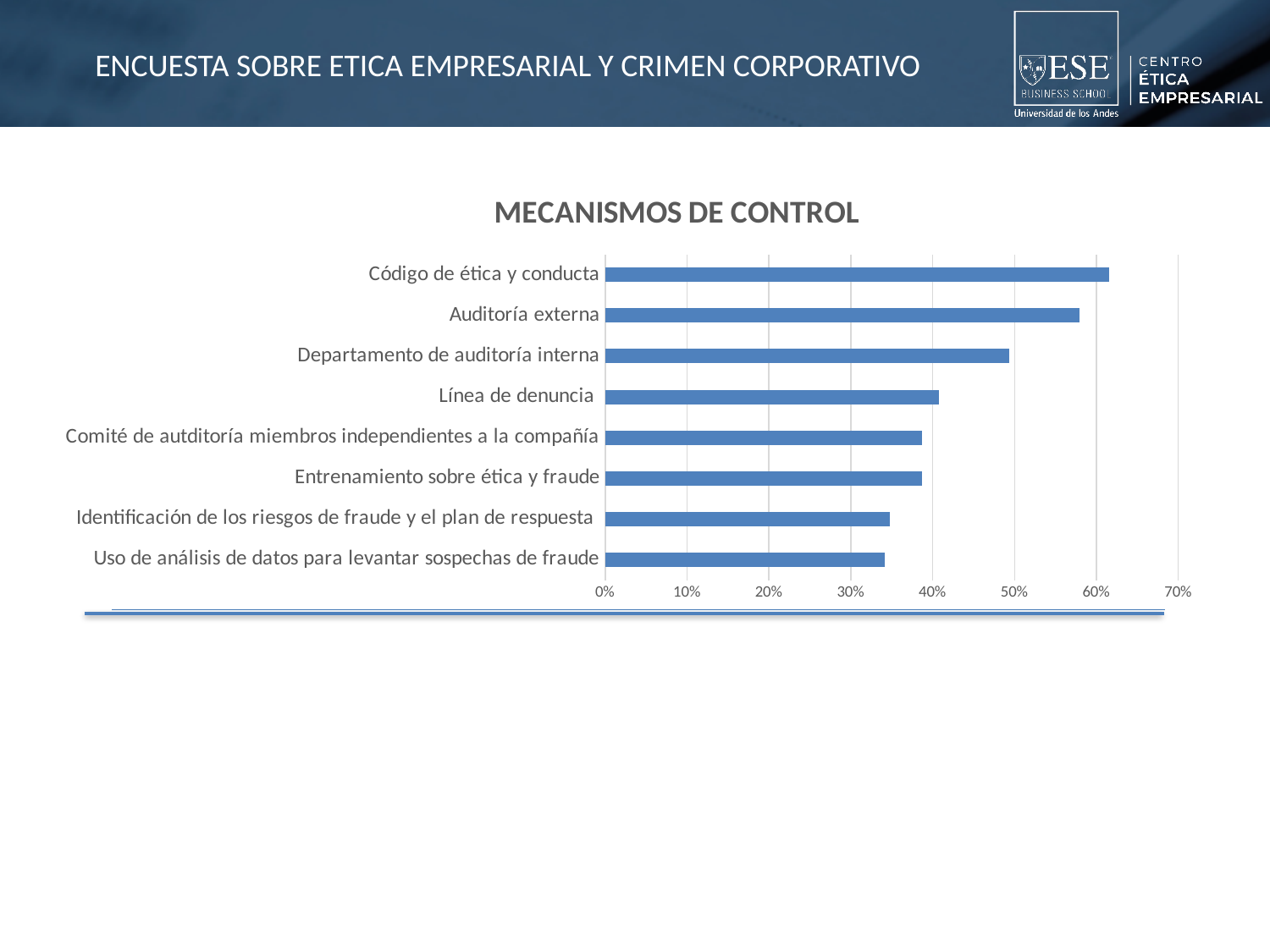
Is the value for Uso de análisis de datos para levantar sospechas de fraude greater or less than 30%? greater Is the value for Auditoría externa greater or less than 50%? greater Which is larger: the value for Departamento de auditoría interna or the value for Línea de denuncia? Departamento de auditoría interna What is the title of the chart on the slide? MECANISMOS DE CONTROL Is the value for Departamento de auditoría interna greater or less than 40%? greater Which control mechanism has the highest value in the chart? Código de ética y conducta How many control mechanisms (categories) are plotted in the chart? 8 Which is larger: the value for Auditoría externa or the value for Entrenamiento sobre ética y fraude? Auditoría externa What kind of chart is shown under the title MECANISMOS DE CONTROL? bar chart